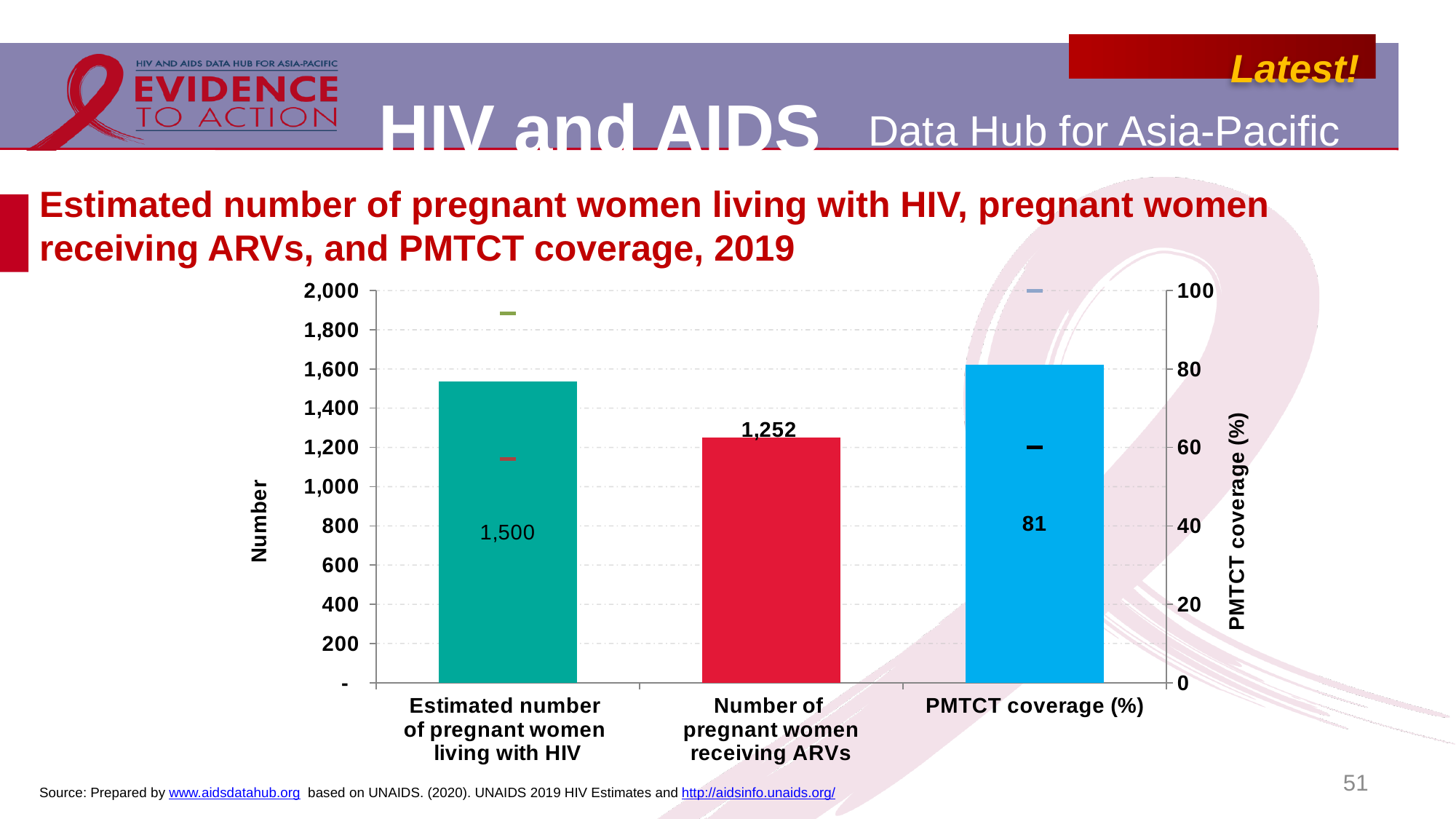
What is the label of the left vertical axis of the chart? Number Is the PMTCT coverage (%) value greater or less than 60 on the right-hand axis? greater How many bars are plotted on the chart? 3 What kind of chart is shown on the slide? Bar chart What is the label of the right vertical axis of the chart? PMTCT coverage (%) Is the value for the number of pregnant women receiving ARVs greater or less than 1,400? less Which is larger: the estimated number of pregnant women living with HIV or the number of pregnant women receiving ARVs? Estimated number of pregnant women living with HIV What is the estimated number of pregnant women living with HIV shown on the chart? 1,500 What is the PMTCT coverage (%) value shown on the chart? 81 What year does the chart title say the data refer to? 2019 What is the number of pregnant women receiving ARVs shown on the chart? 1,252